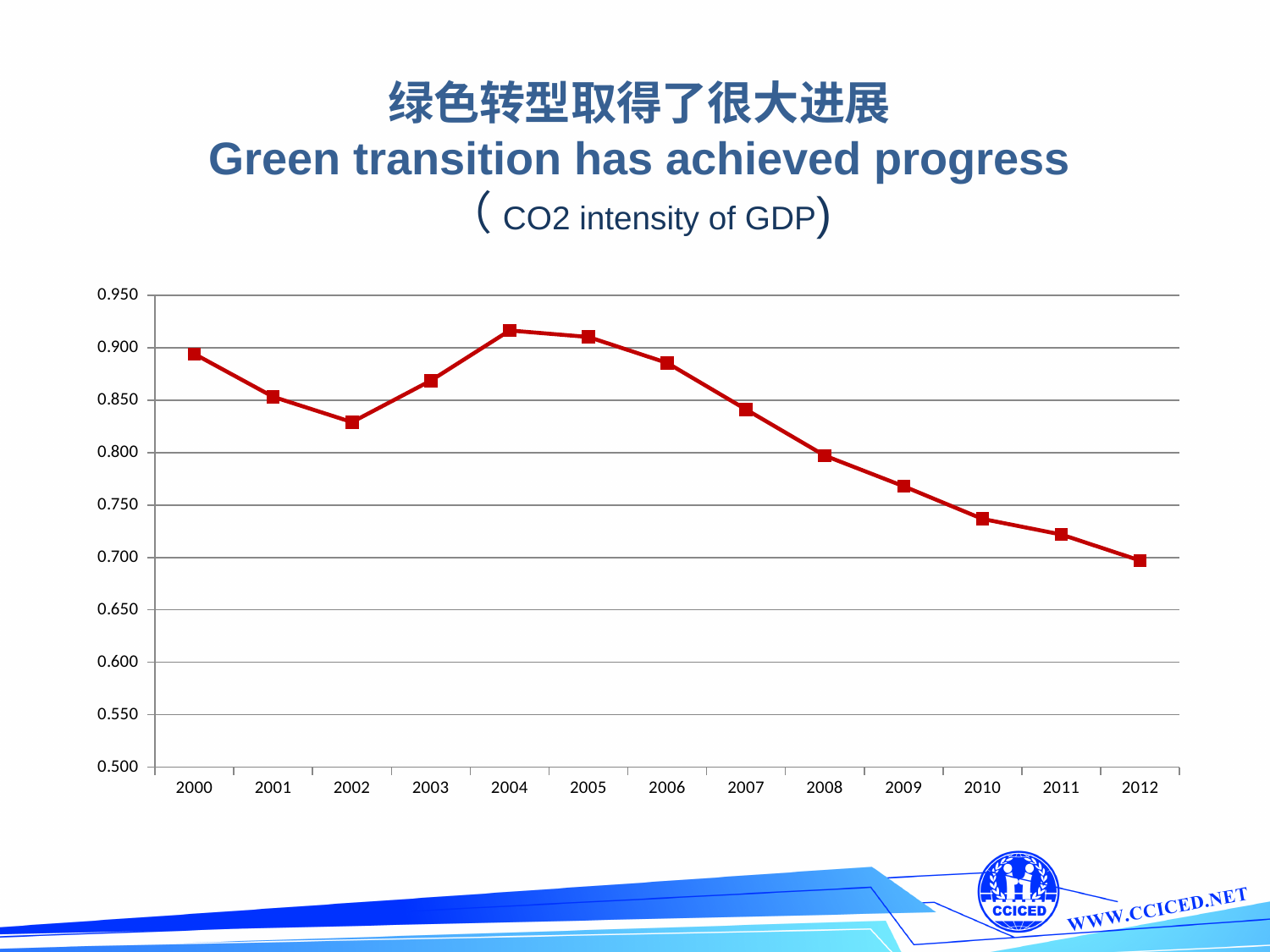
Is the value for 2004 greater or less than 0.900? greater Do the values rise or fall from 2004 to 2012? fall What is the English title of the chart's slide? Green transition has achieved progress Which year has the larger value, 2000 or 2012? 2000 Which year has the highest CO2 intensity of GDP in the chart? 2004 Which year has the larger value, 2002 or 2009? 2002 What kind of chart is shown on the slide? line chart How many years are plotted on the x axis of the chart? 13 Which year has the lowest CO2 intensity of GDP in the chart? 2012 Is the value for 2012 greater or less than 0.750? less Is the value for 2000 greater or less than 0.850? greater